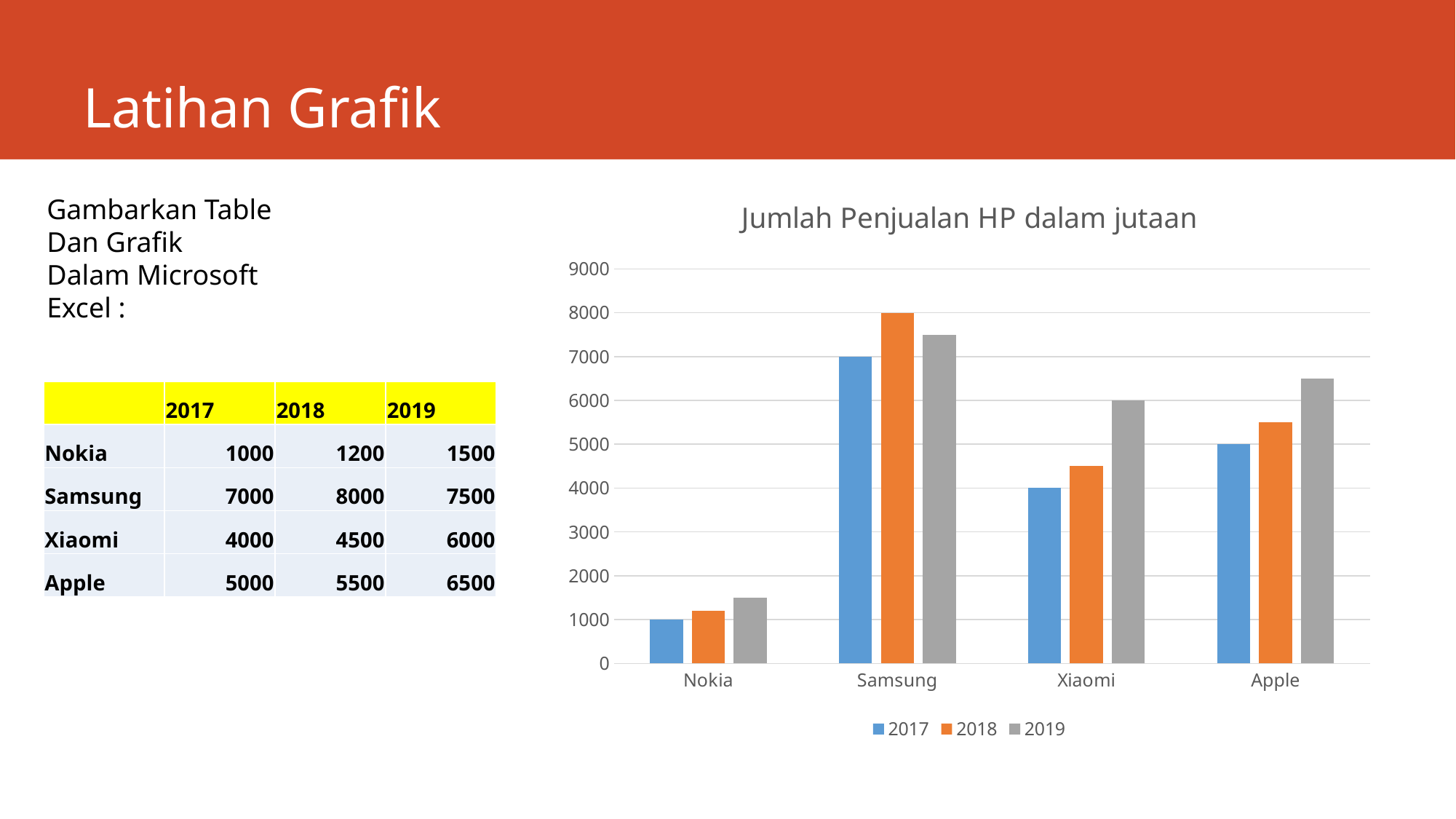
What is the title of the chart? Jumlah Penjualan HP dalam jutaan What is the value for Nokia in 2017? 1000 Which category has the lowest value for the 2019 series? Nokia How many categories are shown on the x axis? 4 How many series does the legend list? 3 Which is larger: Apple's 2019 value or Xiaomi's 2019 value? Apple's 2019 value What is the value for Samsung in 2018? 8000 What kind of chart is shown? bar chart Is the value for Apple in 2018 greater or less than 5000? greater Which category has the highest value for the 2017 series? Samsung What is the difference between Samsung's 2018 value and Samsung's 2017 value? 1000 What is the value for Xiaomi in 2019? 6000